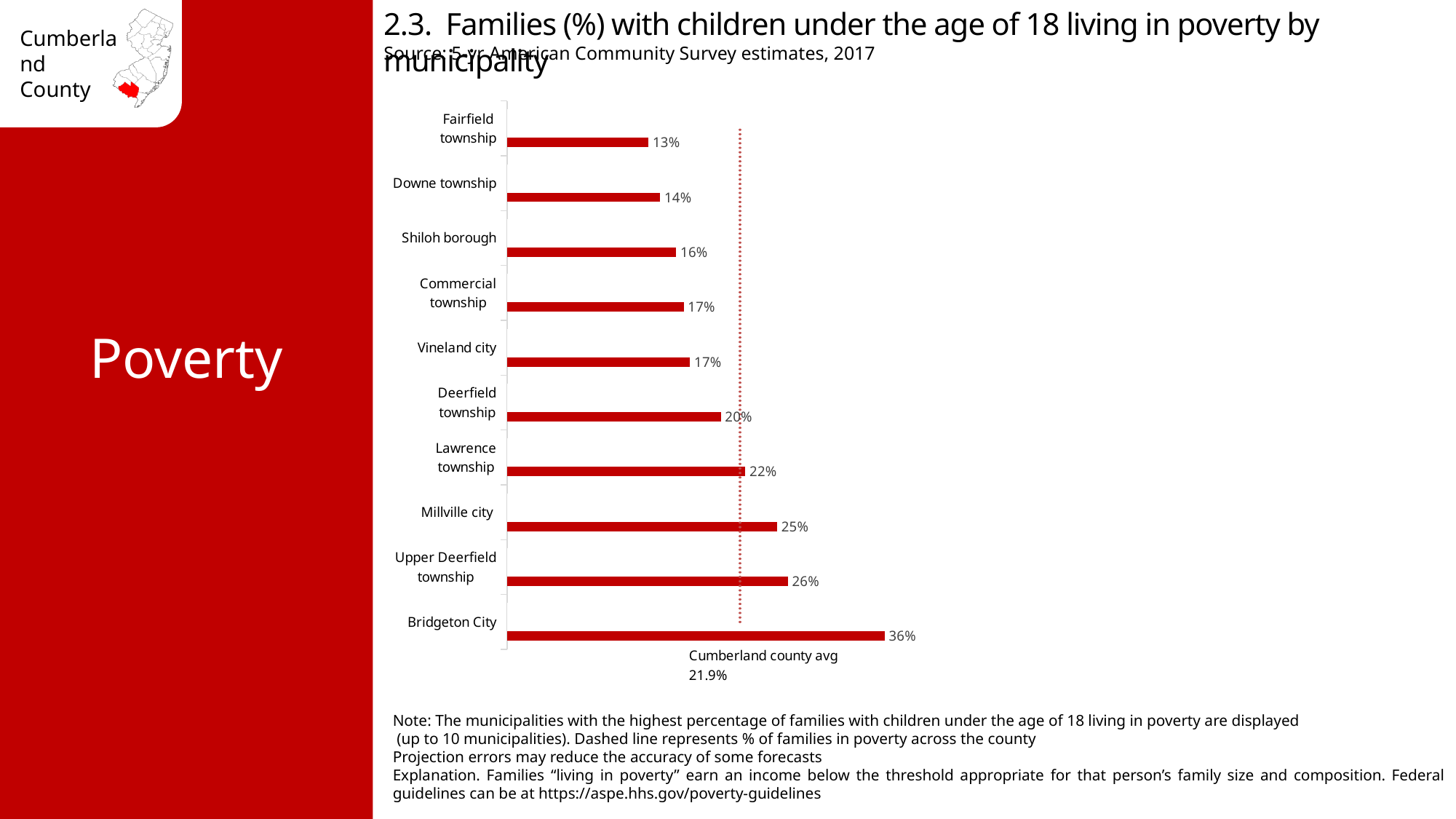
What is the difference between the values for Deerfield township and Fairfield township? 7% What is the value shown for Downe township? 14% What kind of chart is used on this slide? Bar chart Which has a higher value, Lawrence township or Shiloh borough? Lawrence township What is the value shown for Vineland city? 17% Which municipality has the highest percentage of families with children under 18 living in poverty? Bridgeton City Which municipality has the lowest percentage shown on the chart? Fairfield township What is the Cumberland county average shown by the dotted line? 21.9% How many municipalities are shown on the chart? 10 What percentage of families with children under 18 are living in poverty in Bridgeton City? 36% What is the value shown for Millville city? 25% What is the difference between the values for Bridgeton City and Upper Deerfield township? 10%